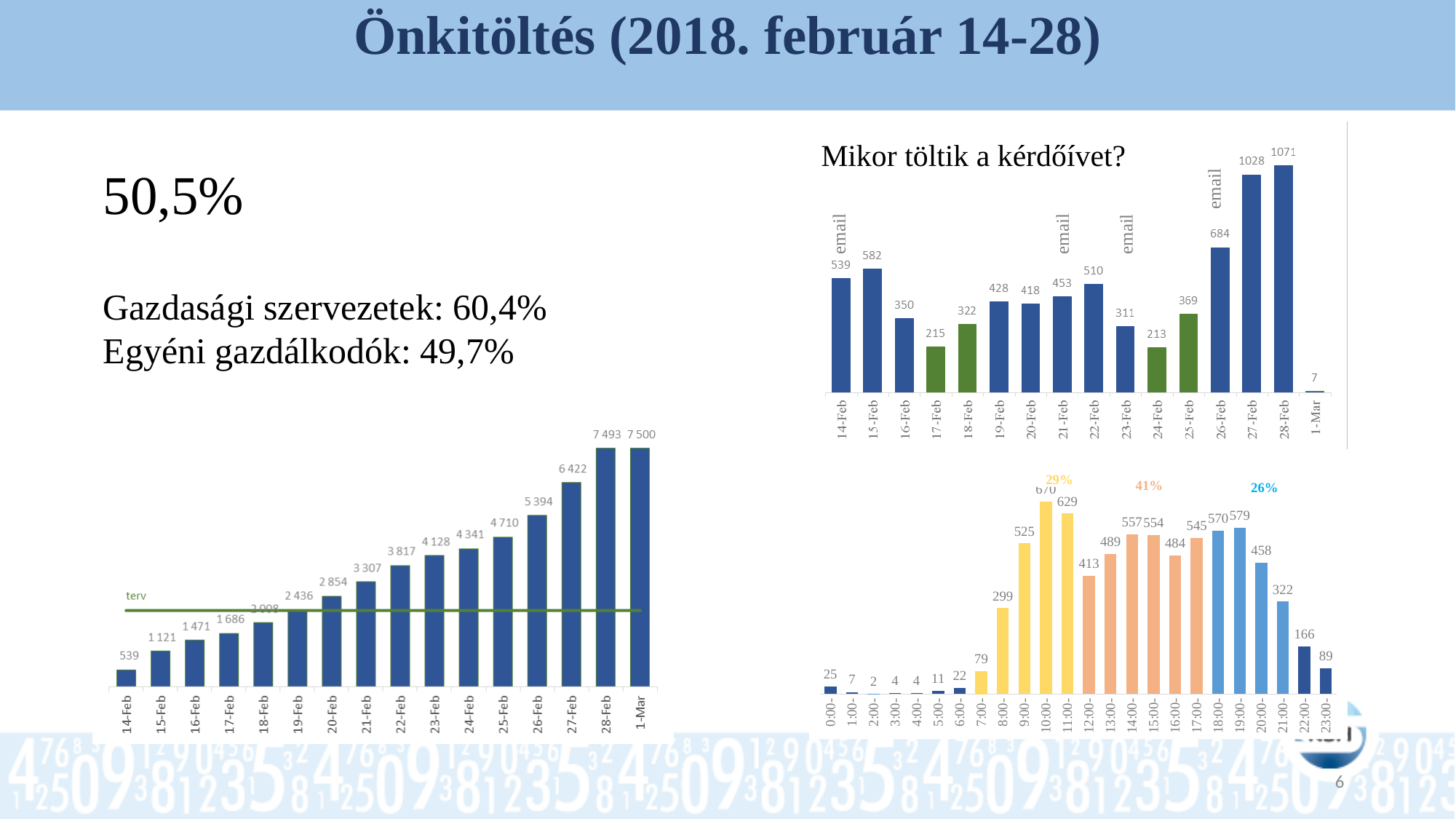
In the bottom-left chart, which date has the lowest value? 14-Feb What kind of chart is the bottom-left chart? bar chart In the bottom-right hourly chart, what is the difference between the values for 9:00 and 8:00? 226 In the top-right chart titled 'Mikor töltik a kérdőívet?', how many dates are shown on the x axis? 16 In the bottom-left chart, what is the value for 1-Mar? 7 500 In the bottom-left chart, what is the difference between the values for 27-Feb and 26-Feb? 1 028 In the top-right chart titled 'Mikor töltik a kérdőívet?', which date has the highest value? 28-Feb In the top-right chart titled 'Mikor töltik a kérdőívet?', which is larger, the value for 17-Feb or the value for 18-Feb? 18-Feb In the bottom-left chart, do the values rise or fall from 14-Feb to 1-Mar? rise In the top-right chart titled 'Mikor töltik a kérdőívet?', what is the value for 26-Feb? 684 In the bottom-right hourly chart, what is the value for 19:00? 579 In the bottom-left chart, what is the value for 28-Feb? 7 493